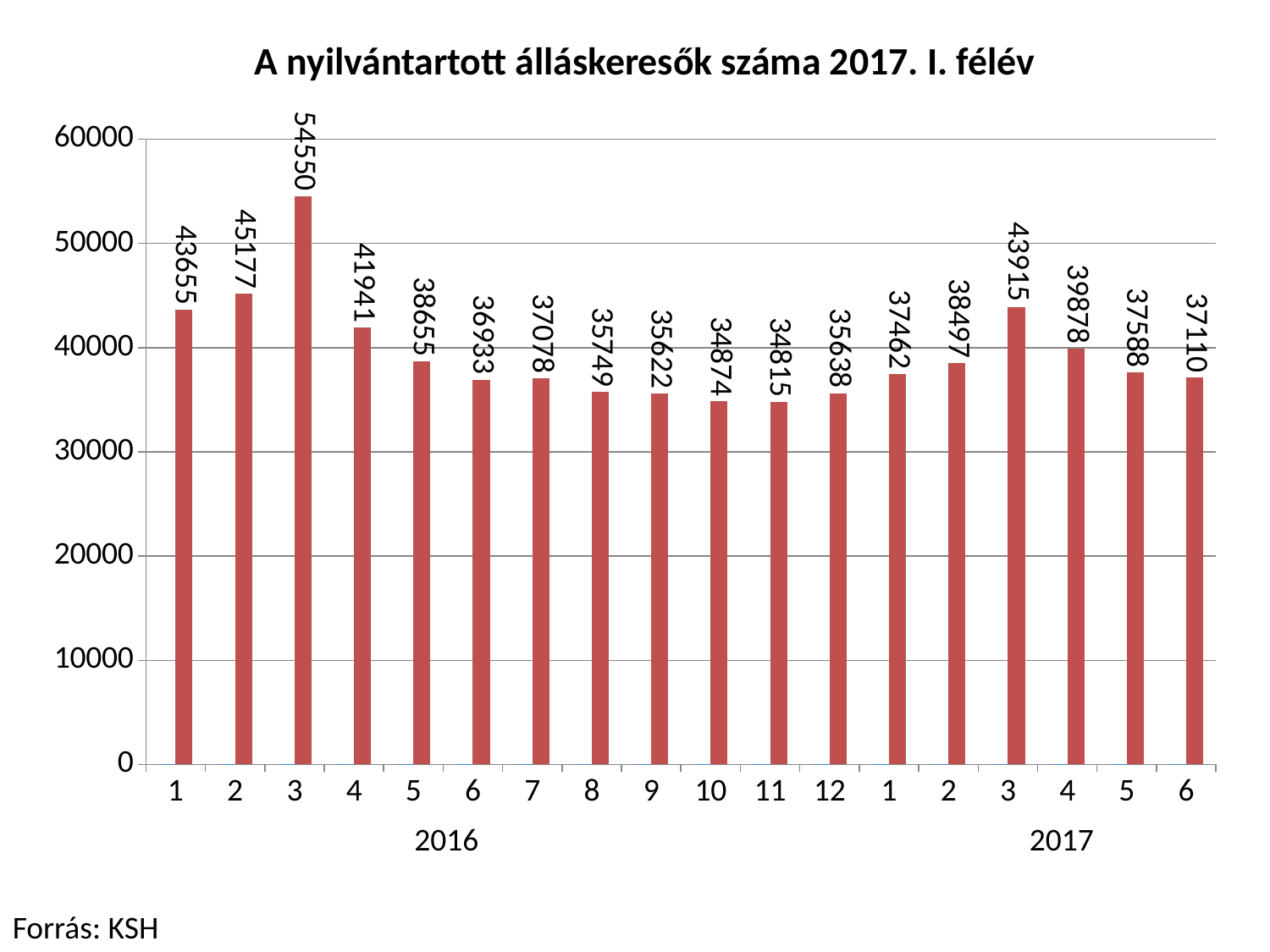
Is the value for month 3 of 2016 greater or less than 50000? greater What is the value for month 6 of 2017? 37110 What is the value for month 3 of 2016? 54550 What is the difference between the values for month 3 of 2016 and month 1 of 2016? 10895 What is the value for month 11 of 2016? 34815 Which month has the lowest value? Month 11 of 2016 Do the values rise or fall from month 3 of 2017 to month 6 of 2017? Fall What kind of chart is shown on the slide? Bar chart What is the difference between the values for month 3 of 2017 and month 6 of 2017? 6805 Which is larger, the value for month 2 of 2016 or the value for month 3 of 2017? Month 2 of 2016 Which month has the highest value? Month 3 of 2016 How many bars are shown in the chart? 18